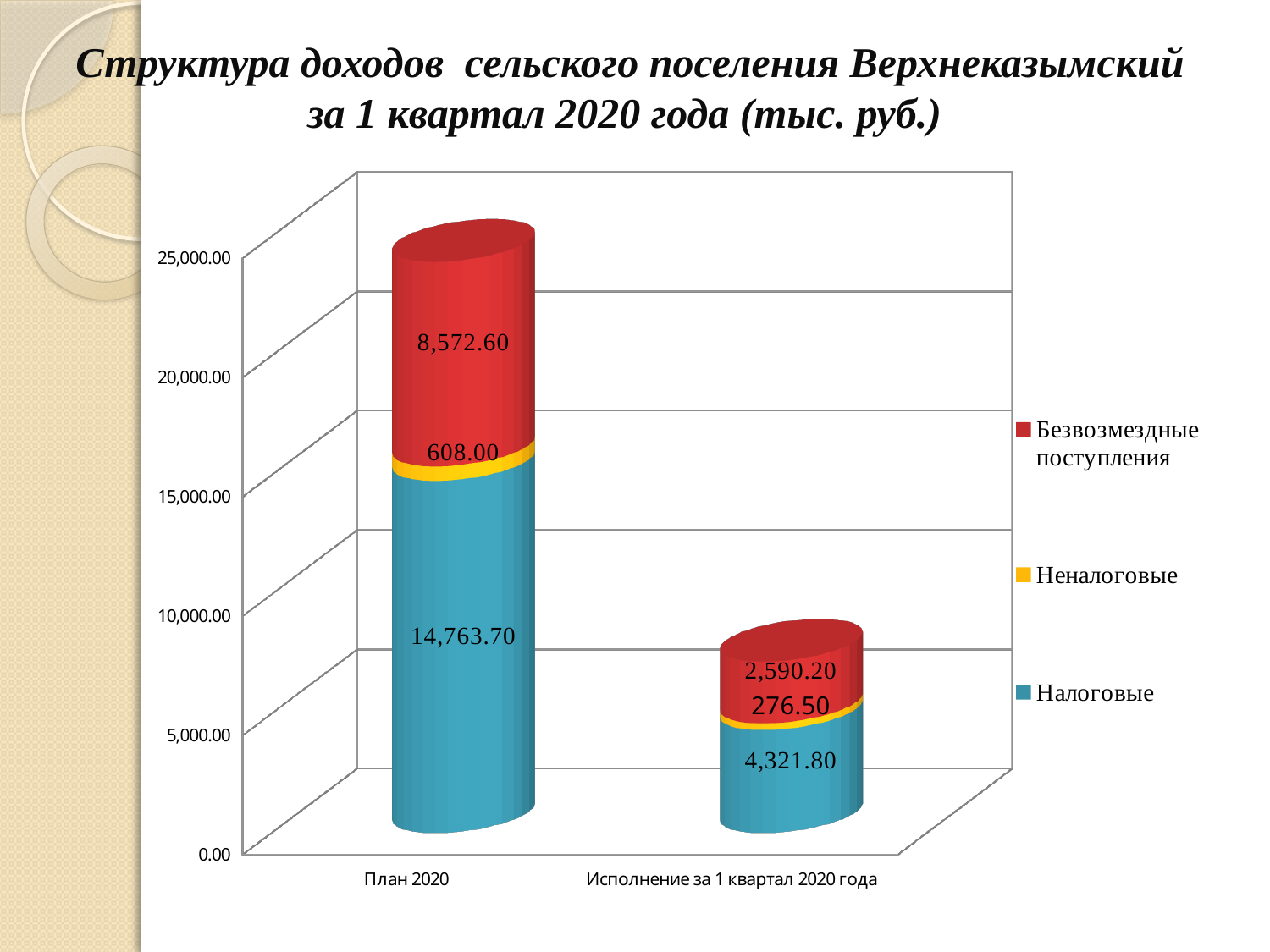
Which series has the largest value in the План 2020 bar? Налоговые What is the value of Неналоговые for План 2020? 608.00 Which is larger: Безвозмездные поступления for План 2020 or Налоговые for Исполнение за 1 квартал 2020 года? Безвозмездные поступления for План 2020 What is the difference between the Налоговые values for План 2020 and Исполнение за 1 квартал 2020 года? 10,441.90 Which series has the smallest value in the Исполнение за 1 квартал 2020 года bar? Неналоговые What kind of chart is shown on the slide? Stacked bar chart What is the value of Налоговые for План 2020? 14,763.70 What is the value of Безвозмездные поступления for Исполнение за 1 квартал 2020 года? 2,590.20 What is the value of Неналоговые for Исполнение за 1 квартал 2020 года? 276.50 What is the difference between the Безвозмездные поступления values for План 2020 and Исполнение за 1 квартал 2020 года? 5,982.40 What is the total of the stacked bar for Исполнение за 1 квартал 2020 года? 7,188.50 How many series does the legend list? 3